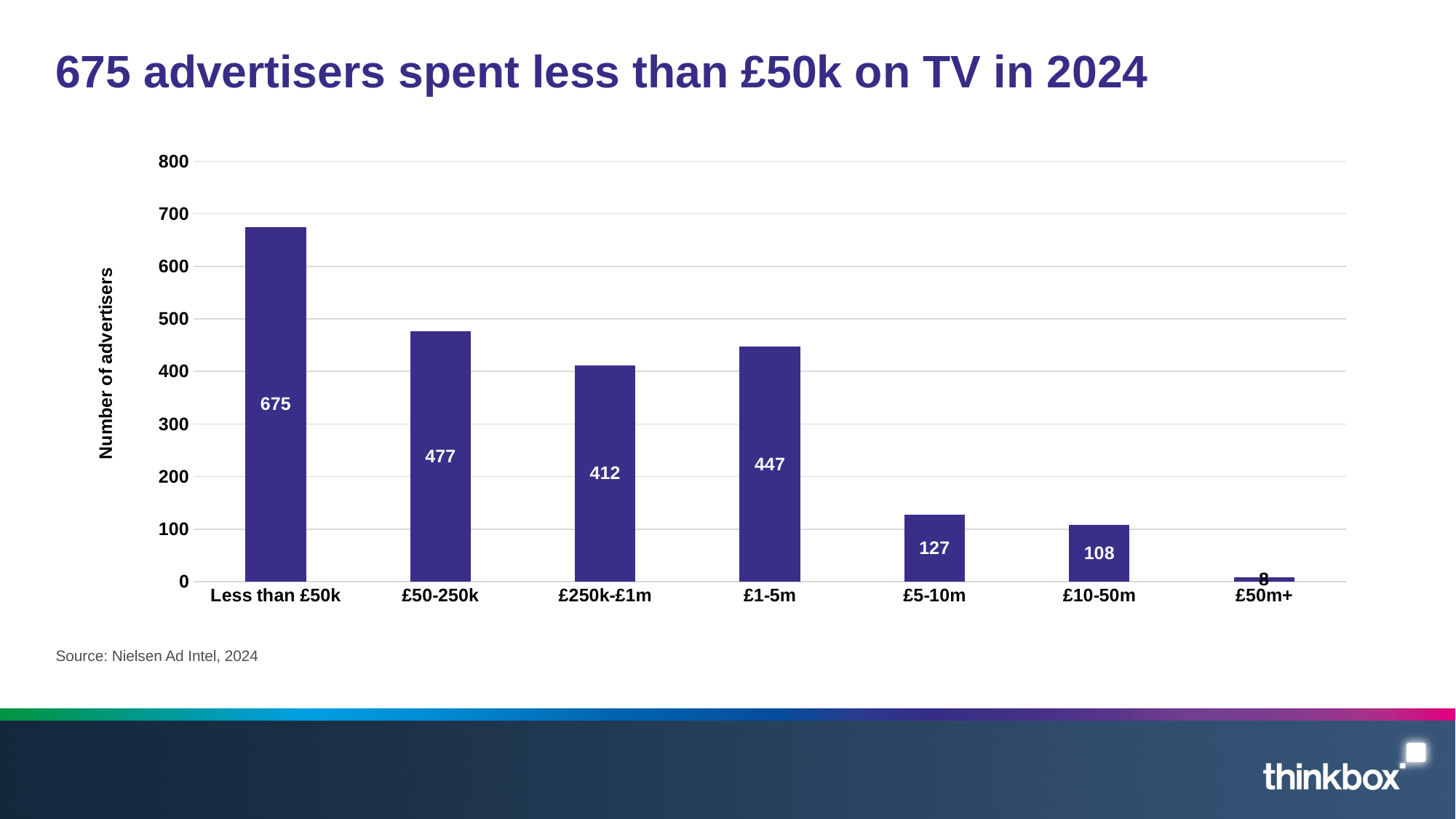
What is the difference in the number of advertisers between the £50-250k band and the £250k-£1m band? 65 What is the number of advertisers in the £1-5m spend band? 447 How many advertisers spent less than £50k on TV in 2024? 675 What is the number of advertisers in the £10-50m spend band? 108 What is the number of advertisers in the £50-250k spend band? 477 How many spend bands are shown on the x axis? 7 Which spend band has the lowest number of advertisers? £50m+ Which spend band has the highest number of advertisers? Less than £50k What is the difference in the number of advertisers between the £5-10m band and the £10-50m band? 19 What kind of chart is shown on the slide? Bar chart Which has more advertisers: the £50-250k band or the £1-5m band? £50-250k What is the label of the vertical axis? Number of advertisers